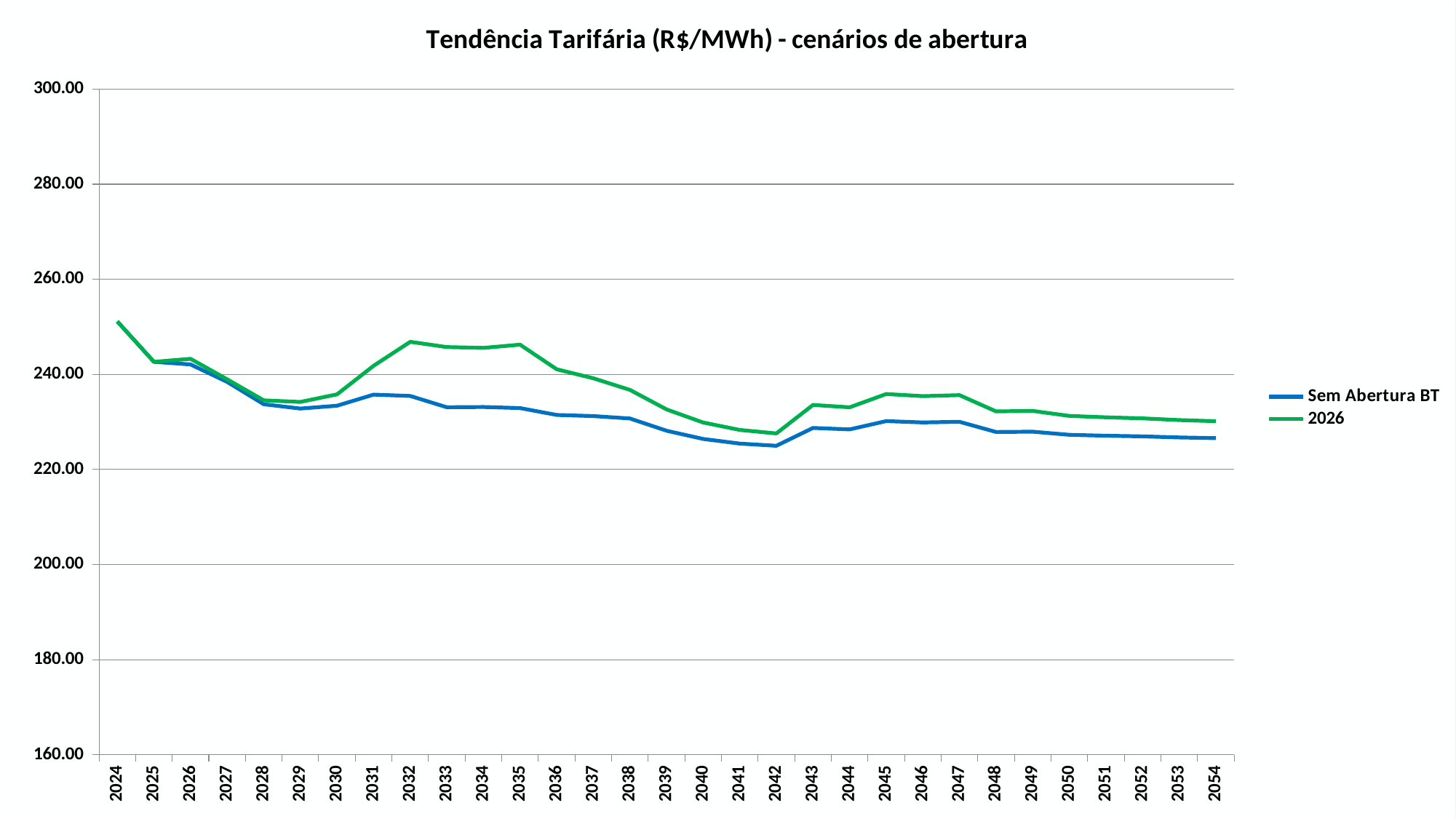
What is the title of the chart? Tendência Tarifária (R$/MWh) - cenários de abertura In which year does the Sem Abertura BT series reach its lowest value? 2042 How many years are plotted along the x axis? 31 In which year does the 2026 series reach its highest value? 2024 Is the value for the 2026 series in 2032 greater or less than 240? greater Overall, do the values of the Sem Abertura BT series rise or fall from 2024 to 2054? fall Is the value for the Sem Abertura BT series in 2042 greater or less than 240? less What kind of chart is shown on the slide? line chart In 2035, which series has the higher value, Sem Abertura BT or 2026? 2026 Which series is drawn in green? 2026 Is the value for the 2026 series in 2024 greater or less than 240? greater How many series does the legend list? 2